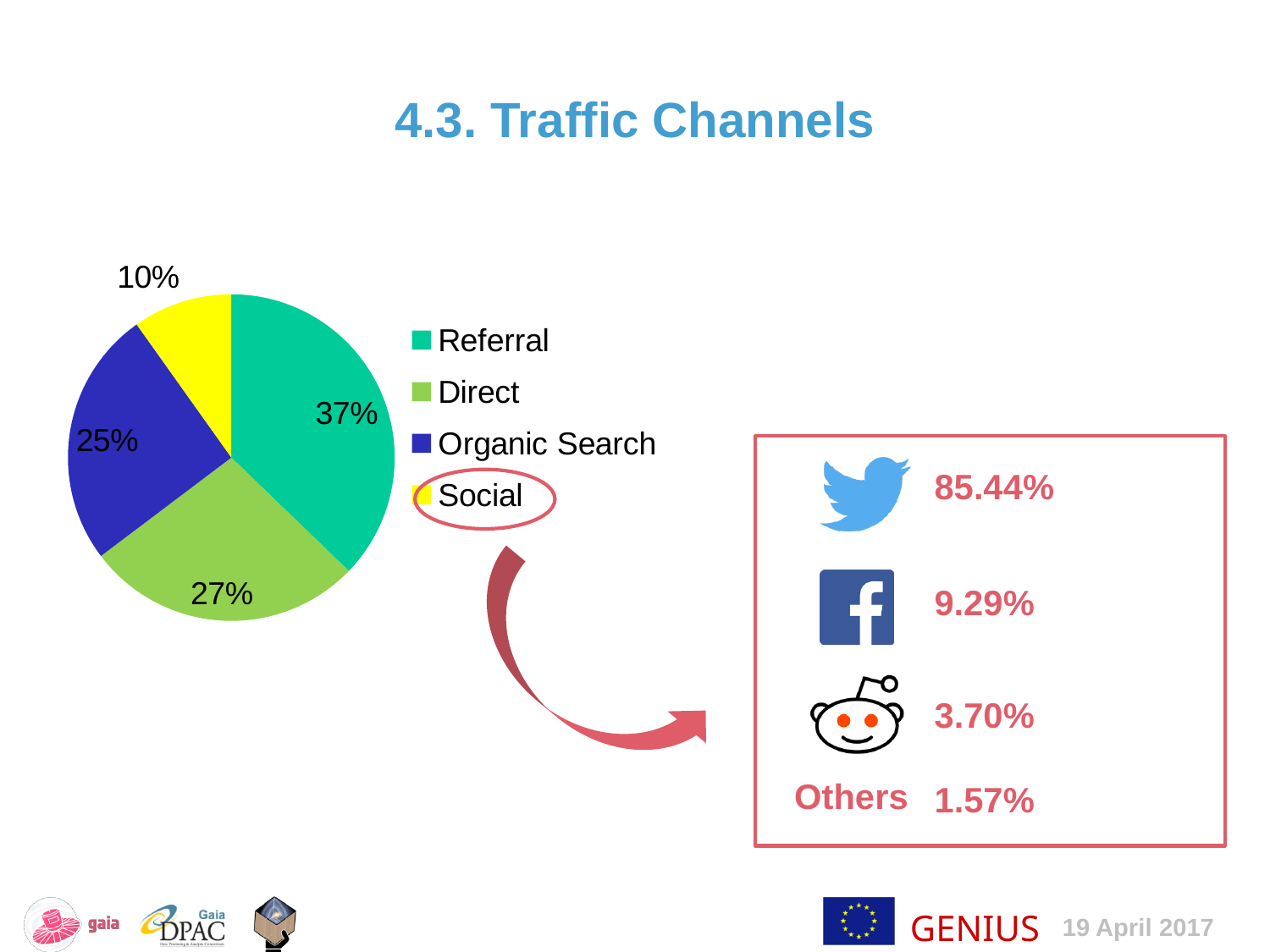
Which traffic channel has the smallest slice of the pie? Social Which traffic channel has the largest slice of the pie? Referral What is the difference between the Direct share and the Organic Search share? 2% How many slices does the pie chart have? 4 What share of the pie does Organic Search have? 25% What kind of chart is shown on the slide? pie chart Which is larger, the Referral slice or the Direct slice? Referral Which legend entry is circled on the slide? Social What is the difference between the Referral share and the Social share? 27% What share of the pie does Referral have? 37% What share of the pie does Direct have? 27% What share of the pie does Social have? 10%